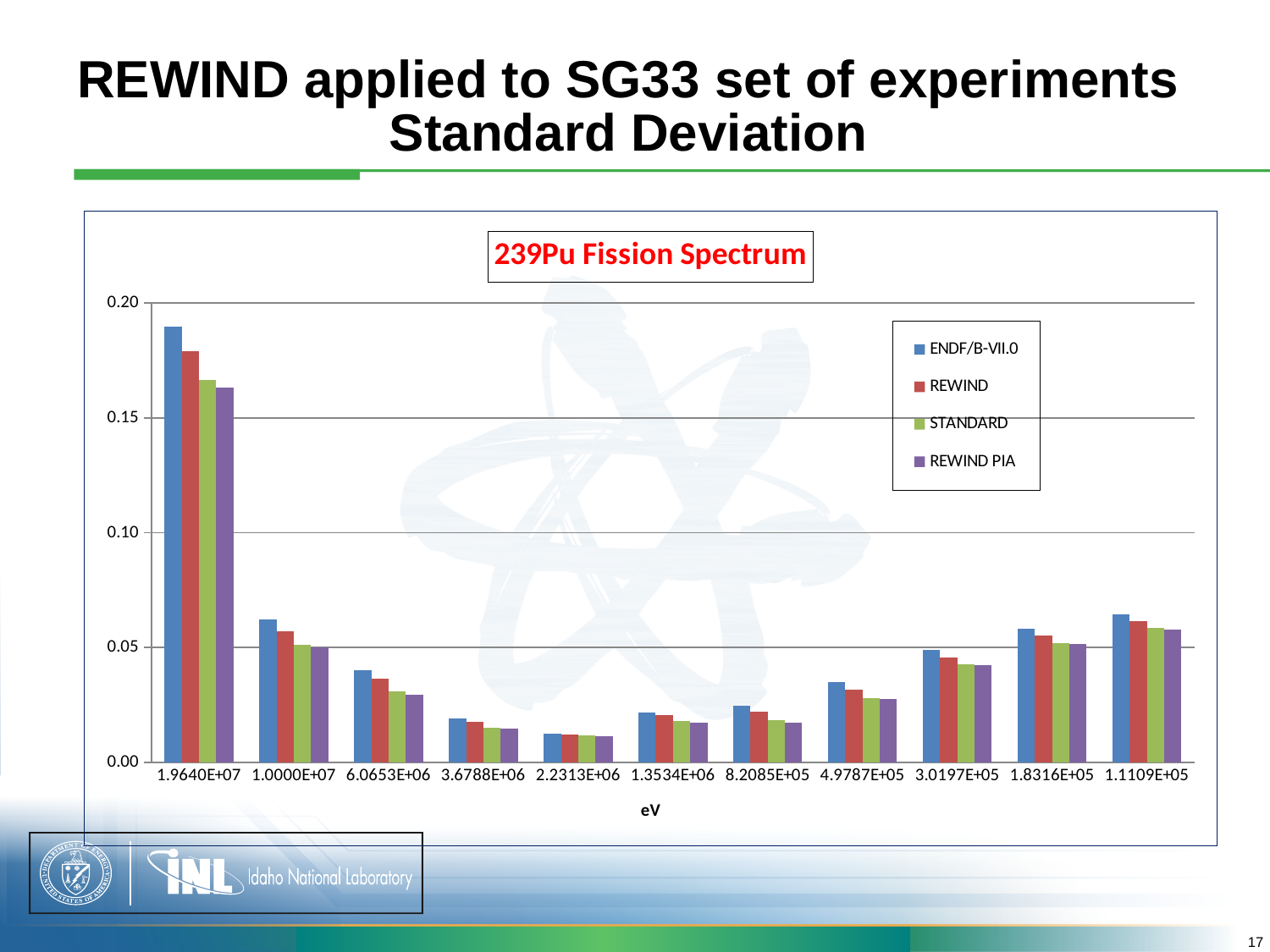
Is the ENDF/B-VII.0 value at 1.9640E+07 greater or less than 0.15? greater How many series does the legend list? 4 What is the title of the chart? 239Pu Fission Spectrum Is the REWIND PIA value at 2.2313E+06 greater or less than 0.05? less Is the ENDF/B-VII.0 value at 6.0653E+06 greater or less than 0.05? less What kind of chart is shown on the slide? Bar chart Do the ENDF/B-VII.0 values rise or fall from 1.9640E+07 to 2.2313E+06 along the x axis? fall Which energy category has the highest ENDF/B-VII.0 value? 1.9640E+07 How many energy categories are shown on the x axis? 11 At 1.9640E+07, which series has the larger value, ENDF/B-VII.0 or REWIND PIA? ENDF/B-VII.0 Which energy category has the lowest ENDF/B-VII.0 value? 2.2313E+06 What is the label of the x axis? eV